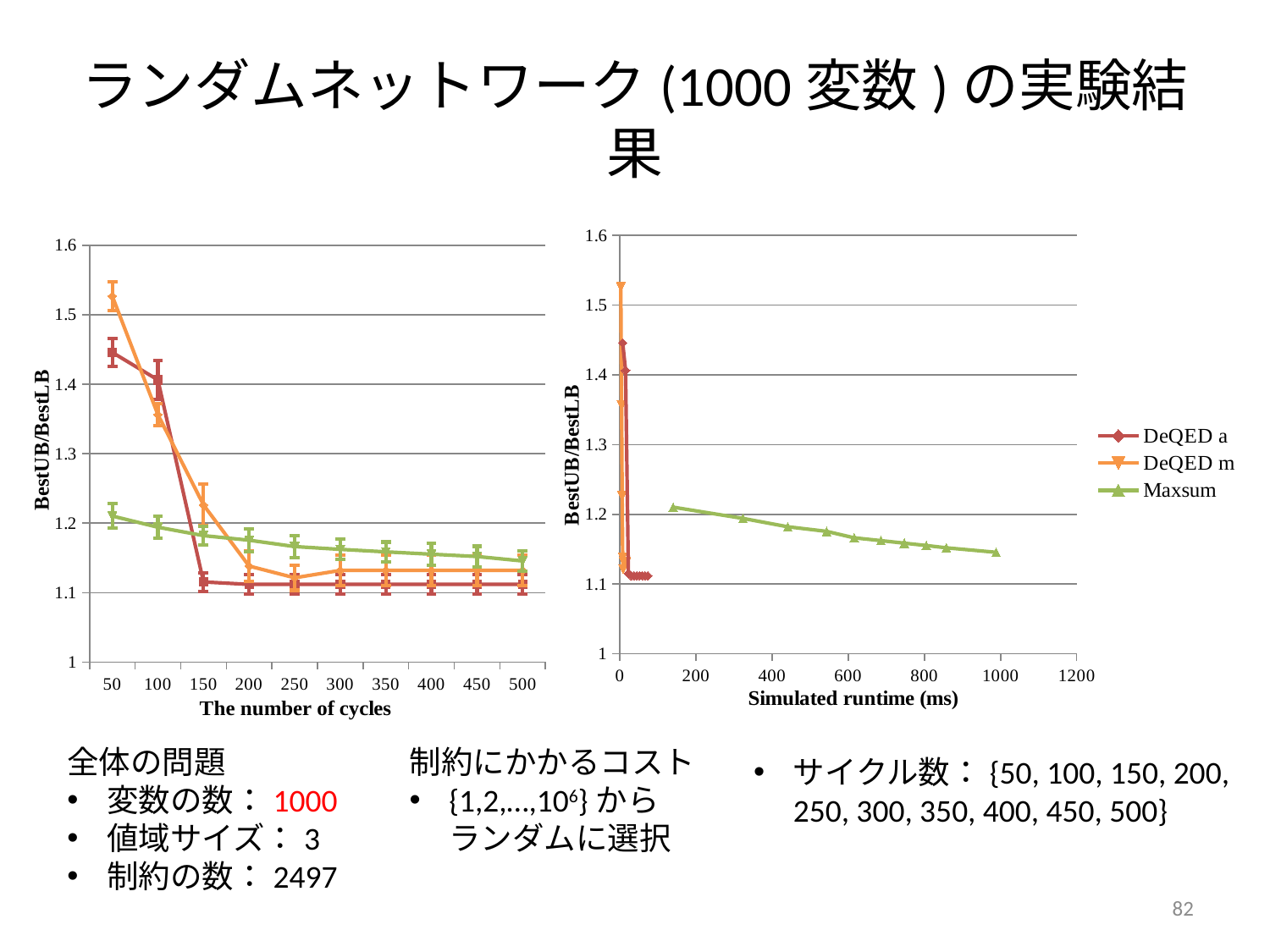
In the left chart (The number of cycles), does the Maxsum series rise or fall as the number of cycles increases? fall How many series does the legend list? 3 In the left chart (The number of cycles), is the value for DeQED a at 500 cycles greater or less than 1.2? less In the right chart (Simulated runtime), does the Maxsum series rise or fall as simulated runtime increases? fall In the left chart (The number of cycles), which series has the lowest value at 50 cycles? Maxsum In the left chart (The number of cycles), is the value for DeQED m at 50 cycles greater or less than 1.5? greater In the left chart (The number of cycles), which series has the higher value at 500 cycles, Maxsum or DeQED a? Maxsum In the left chart (The number of cycles), which series has the higher value at 50 cycles, DeQED a or DeQED m? DeQED m In the left chart (The number of cycles), is the value for Maxsum at 50 cycles greater or less than 1.3? less In the left chart (The number of cycles), how many x-axis categories are plotted? 10 What is the x-axis title of the right chart? Simulated runtime (ms) What kind of chart is the left chart (The number of cycles)? line chart